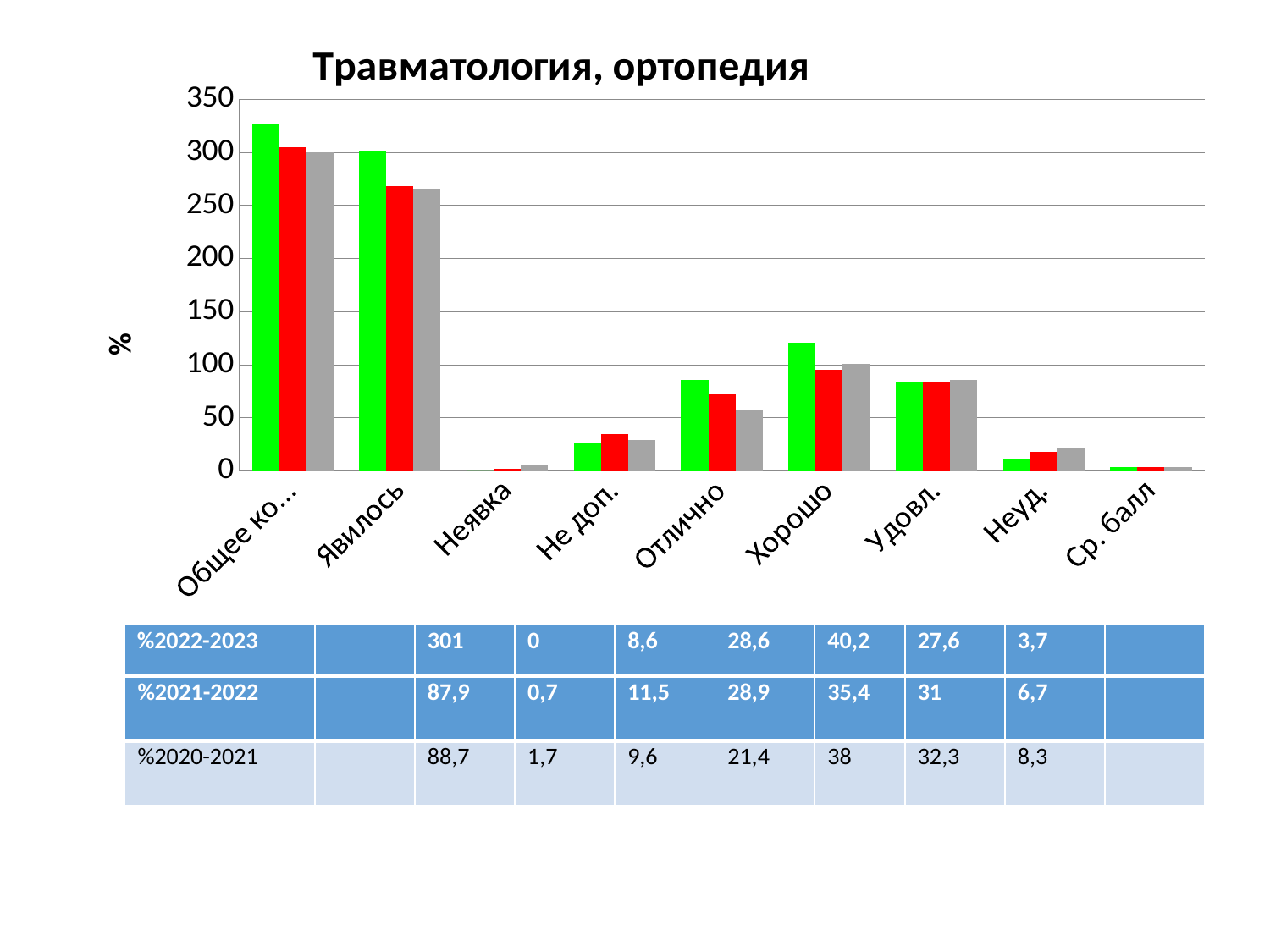
Which category has the lowest bars in the chart? Неявка Is the green bar for Не доп. greater or less than 50? less Which category has the tallest bar in the chart? Общее ко... What label is shown on the vertical axis of the chart? % Is the green bar for Хорошо greater or less than 100? greater What type of chart is shown on the slide? bar chart Is the red bar for Явилось greater or less than 300? less Which green bar is taller: Отлично or Хорошо? Хорошо How many bars are plotted for each category in the chart? 3 What is the title of the chart? Травматология, ортопедия How many categories are shown on the x axis of the chart? 9